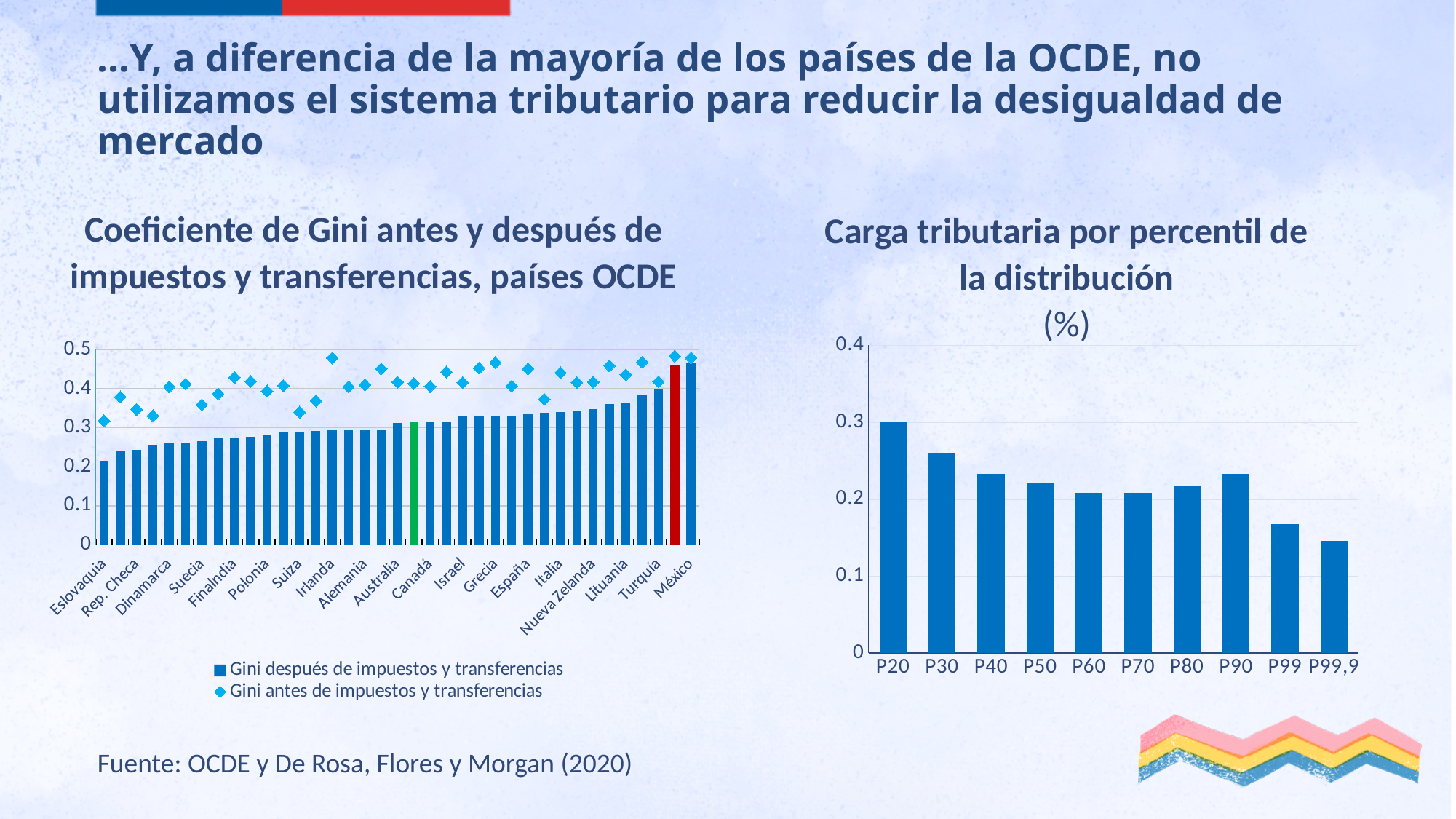
On the 'Coeficiente de Gini antes y después de impuestos y transferencias, países OCDE' chart, which labelled country has the lowest Gini después de impuestos y transferencias? Eslovaquia On the 'Carga tributaria por percentil de la distribución' chart, which is larger, the value for P30 or the value for P90? P30 On the 'Carga tributaria por percentil de la distribución' chart, do the values rise or fall from P20 to P60? fall On the 'Carga tributaria por percentil de la distribución' chart, is the value for P30 greater or less than 0.2? greater On the 'Carga tributaria por percentil de la distribución' chart, which percentile has the lowest value? P99,9 On the 'Coeficiente de Gini antes y después de impuestos y transferencias, países OCDE' chart, is the Gini después de impuestos y transferencias for Eslovaquia greater or less than 0.3? less How many percentile categories are shown on the 'Carga tributaria por percentil de la distribución' chart? 10 On the 'Carga tributaria por percentil de la distribución' chart, is the value for P99,9 greater or less than 0.2? less How many series does the legend of the 'Coeficiente de Gini antes y después de impuestos y transferencias, países OCDE' chart list? 2 On the 'Carga tributaria por percentil de la distribución' chart, which percentile has the highest value? P20 What kind of chart is the 'Carga tributaria por percentil de la distribución' chart? bar chart On the 'Coeficiente de Gini antes y después de impuestos y transferencias, países OCDE' chart, which series is shown with diamond markers? Gini antes de impuestos y transferencias